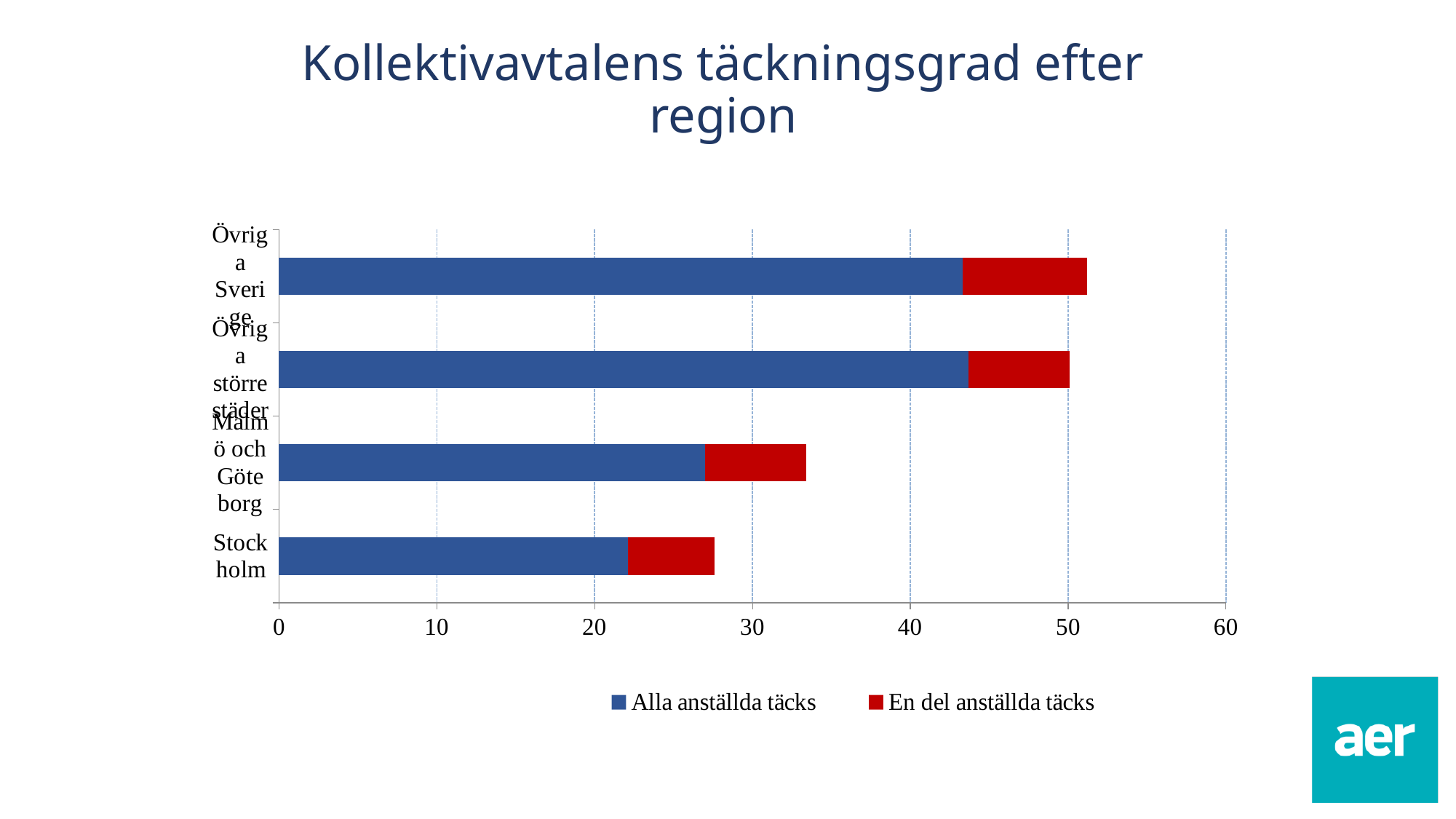
Is the total stacked bar for Stockholm greater or less than 30? less Which has the larger value for 'Alla anställda täcks', Malmö och Göteborg or Stockholm? Malmö och Göteborg Which region has the shortest total stacked bar? Stockholm Which region has the lowest value for 'Alla anställda täcks'? Stockholm What is the title of the chart? Kollektivavtalens täckningsgrad efter region Which series is shown in red? En del anställda täcks How many series does the legend list? 2 Is the value for 'Alla anställda täcks' in Malmö och Göteborg greater or less than 30? less How many regions (categories) are plotted in the chart? 4 What kind of chart is shown on the slide? bar chart Is the value for 'Alla anställda täcks' in Stockholm greater or less than 20? greater